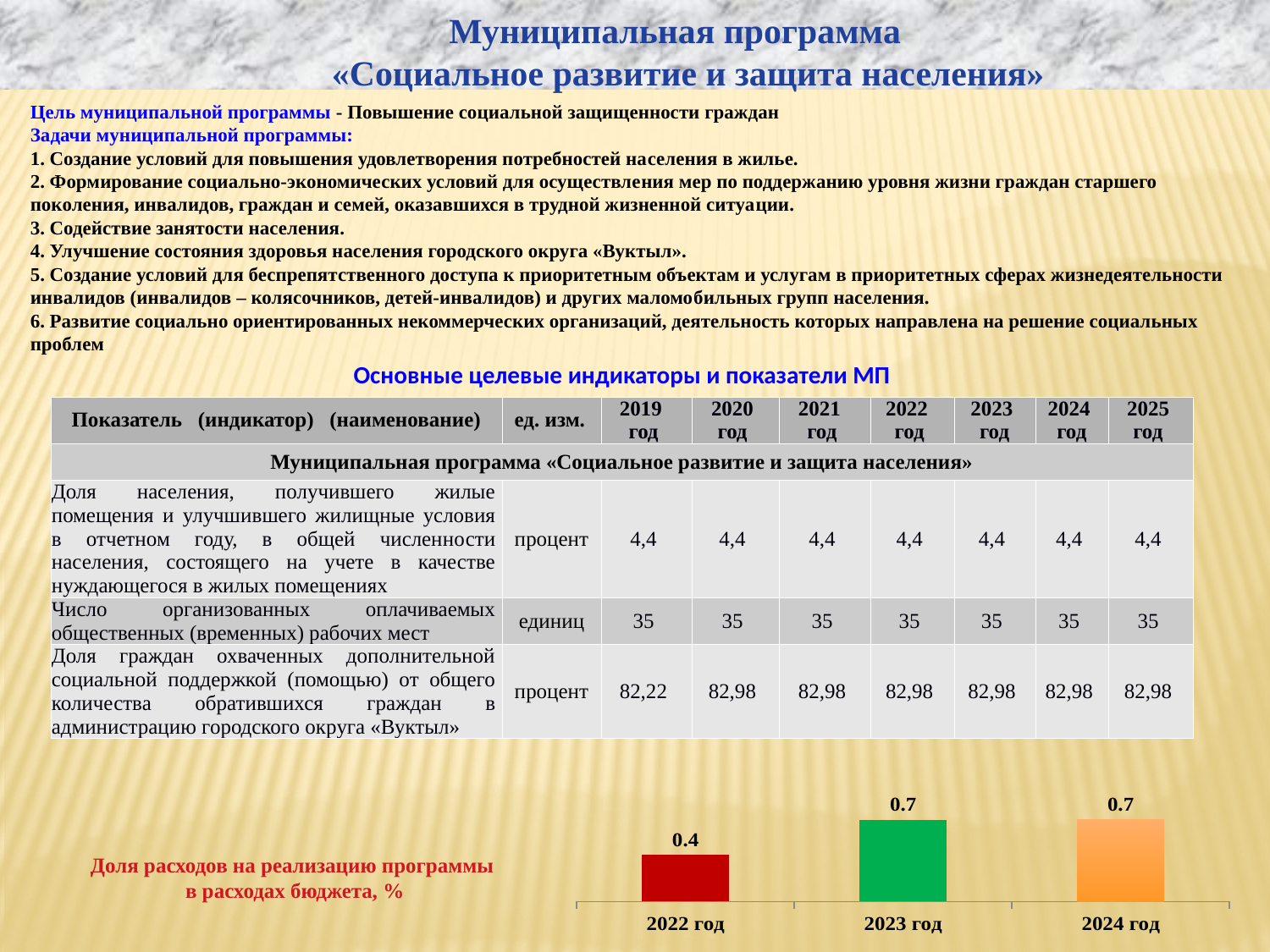
What is the value for 2023 год in the bar chart? 0.7 What type of chart is shown at the bottom of the slide? Bar chart Do the values in the bar chart rise or fall from 2022 год to 2023 год? Rise What is the total of the three values shown in the bar chart? 1.8 Which is larger in the bar chart, the value for 2022 год or the value for 2024 год? 2024 год What is the difference between the values for 2023 год and 2022 год in the bar chart? 0.3 What is the value for 2024 год in the bar chart? 0.7 What colour is the bar for 2023 год in the bar chart? Green What is the value for 2022 год in the bar chart? 0.4 How many bars are shown in the bar chart? 3 What is the title text next to the bar chart? Доля расходов на реализацию программы в расходах бюджета, % Which year has the lowest value in the bar chart? 2022 год